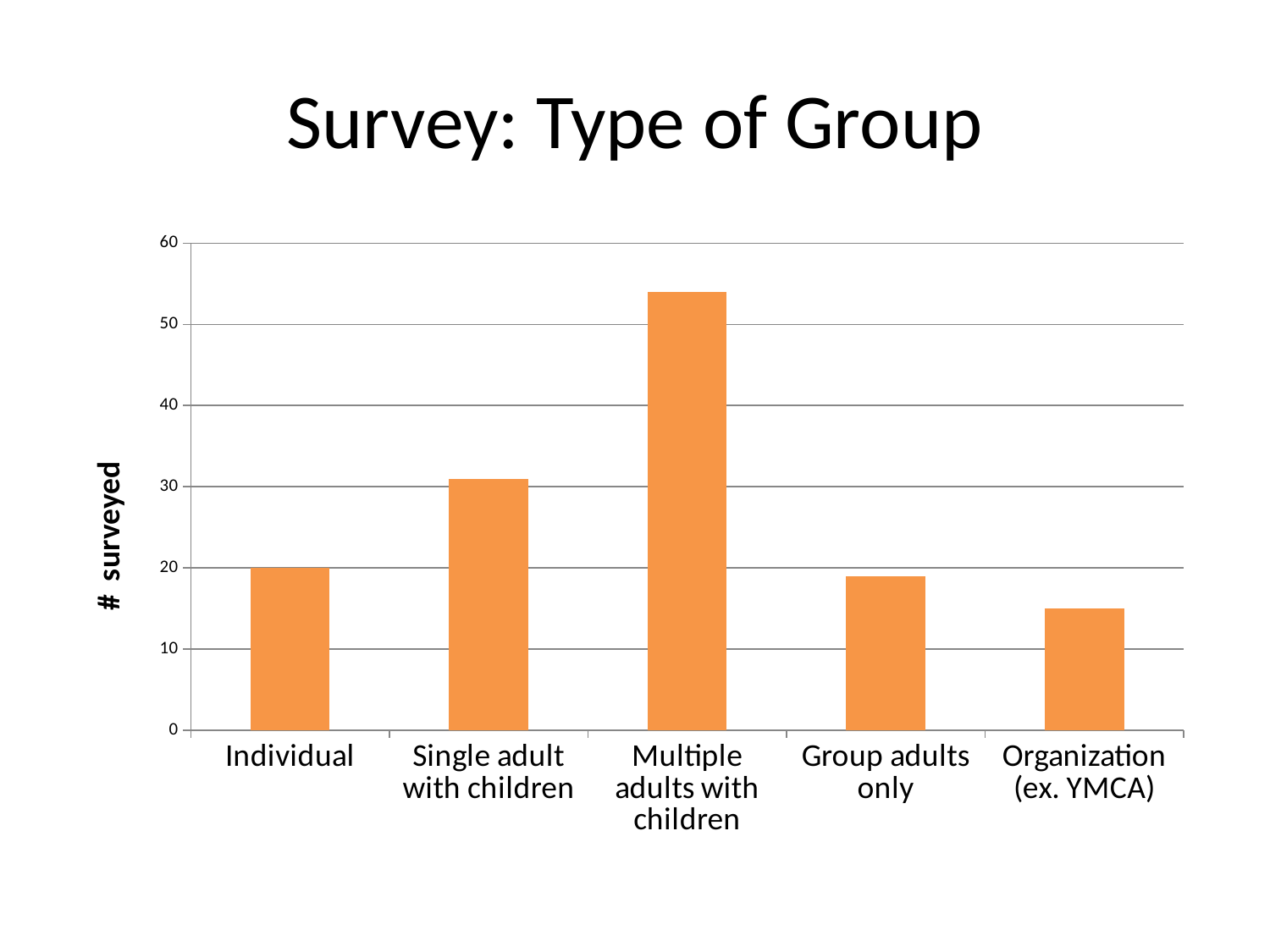
What is the label of the vertical axis? # surveyed How many categories are shown on the x axis of the chart? 5 Which type of group has the highest number surveyed? Multiple adults with children What is the number surveyed for Individual? 20 Is the value for Organization (ex. YMCA) greater or less than 20? less Is the value for Multiple adults with children greater or less than 50? greater What is the title of the chart on the slide? Survey: Type of Group Which is larger: the value for Single adult with children or the value for Individual? Single adult with children Which type of group has the lowest number surveyed? Organization (ex. YMCA) What type of chart is shown on the slide? bar chart